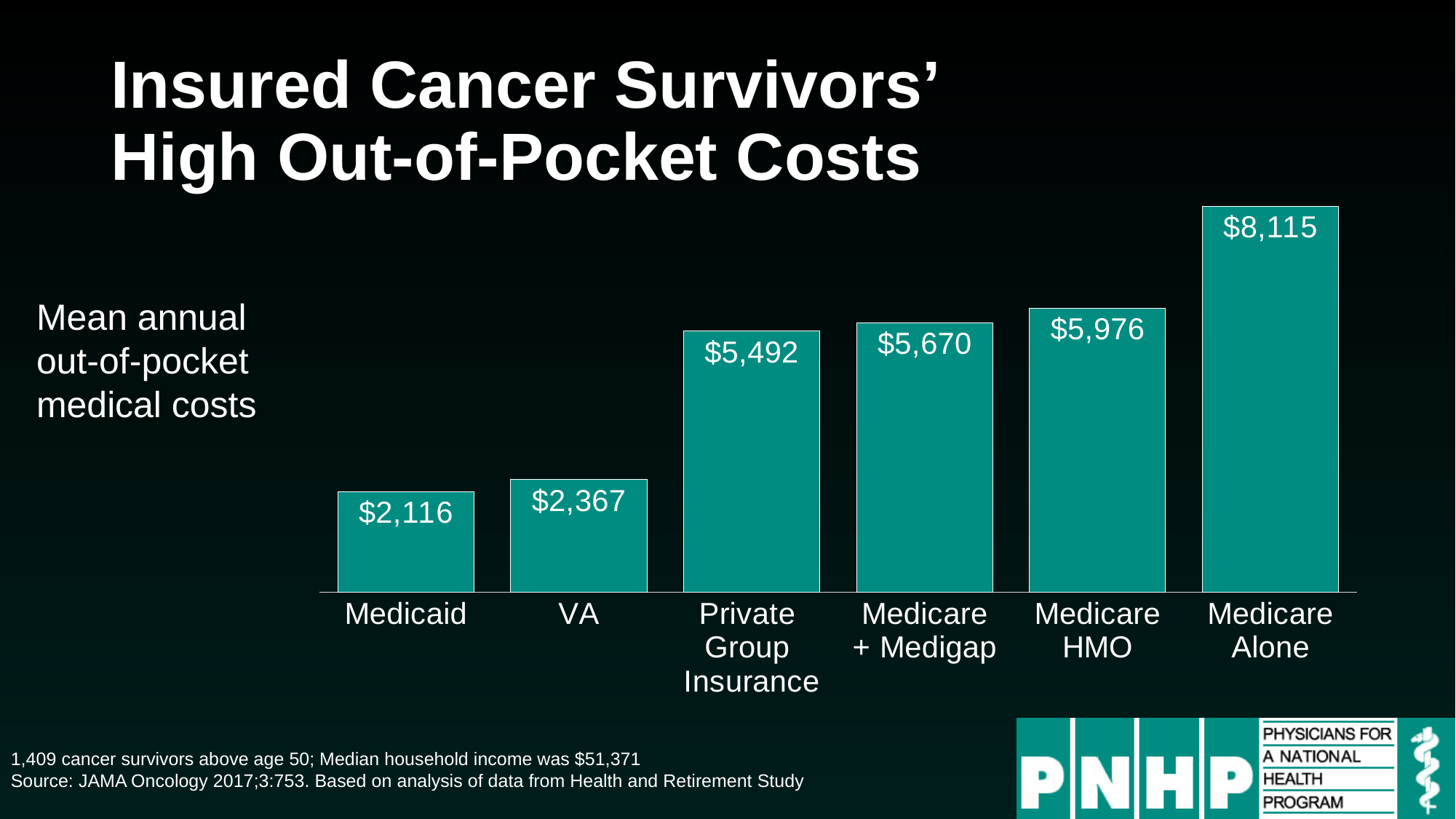
What is the mean annual out-of-pocket medical cost for Private Group Insurance? $5,492 How many insurance categories are shown in the chart? 6 Which insurance category has the lowest mean annual out-of-pocket medical cost? Medicaid Do the values rise or fall moving from left to right across the categories? Rise Which has a higher mean annual out-of-pocket cost, Medicare + Medigap or Private Group Insurance? Medicare + Medigap What is the difference between the out-of-pocket costs for Medicare Alone and Medicaid? $5,999 What is the difference between the out-of-pocket costs for VA and Medicaid? $251 What is the mean annual out-of-pocket medical cost for Medicaid? $2,116 Which insurance category has the highest mean annual out-of-pocket medical cost? Medicare Alone What kind of chart is shown on the slide? Bar chart What is the mean annual out-of-pocket medical cost for Medicare HMO? $5,976 Which has a higher mean annual out-of-pocket cost, VA or Medicare HMO? Medicare HMO